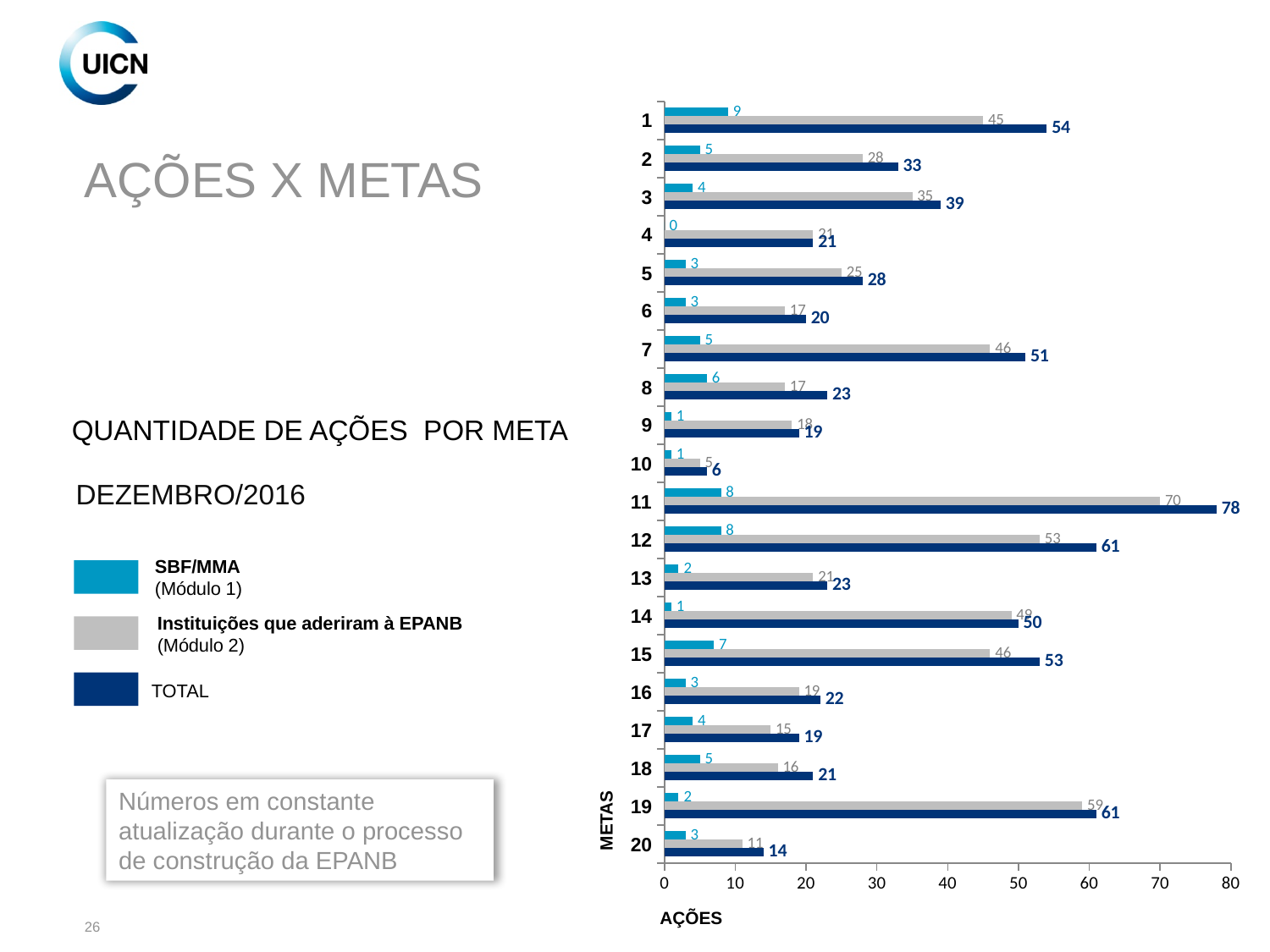
Which is larger, the TOTAL for Meta 7 or the TOTAL for Meta 15? Meta 15 What is the TOTAL value for Meta 11? 78 Which Meta has the lowest SBF/MMA (Módulo 1) value? 4 Which Meta has the highest TOTAL value? 11 Which Meta has the lowest TOTAL value? 10 How many series does the legend list? 3 What kind of chart is shown on the slide? Bar chart How many Metas (categories) are shown on the chart? 20 What is the value for Instituições que aderiram à EPANB (Módulo 2) for Meta 19? 59 What is the difference between the TOTAL values for Meta 11 and Meta 12? 17 What is the label of the horizontal axis of the chart? AÇÕES What is the SBF/MMA (Módulo 1) value for Meta 1? 9